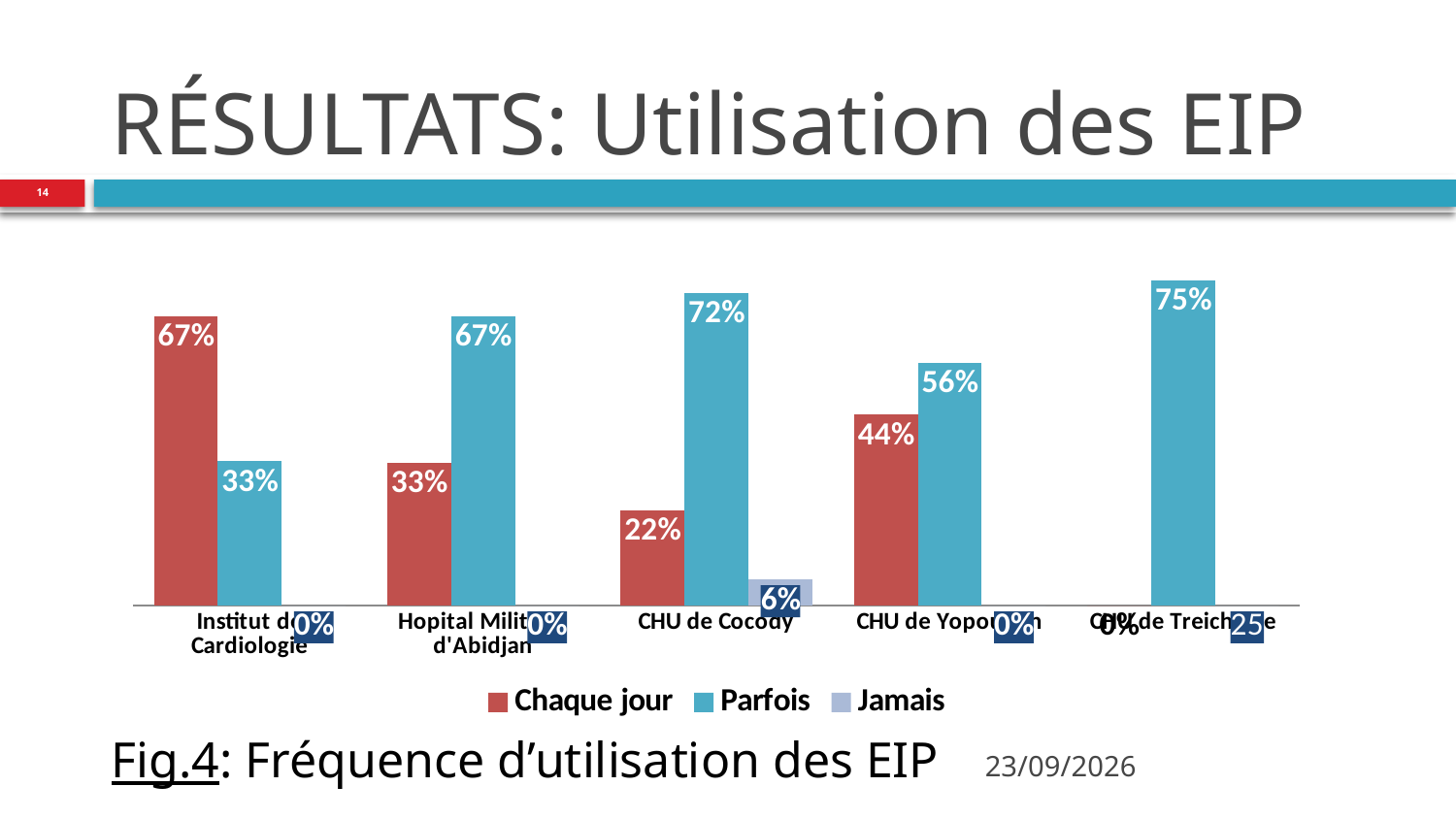
What is the highest Parfois value shown on the chart? 75% How many series does the legend list? 3 What is the Chaque jour value for CHU de Yopougon? 44% Which category has the highest Chaque jour value? Institut de Cardiologie Which category has the lowest Chaque jour value among the first four categories (Institut de Cardiologie, Hopital Militaire d'Abidjan, CHU de Cocody, CHU de Yopougon)? CHU de Cocody What kind of chart is shown on the slide? Bar chart What is the difference between the Parfois and Chaque jour values for Hopital Militaire d'Abidjan? 34 percentage points For Institut de Cardiologie, which is larger: Chaque jour or Parfois? Chaque jour What is the Parfois value for CHU de Cocody? 72% What is the Jamais value for CHU de Cocody? 6% What is the Parfois value for Hopital Militaire d'Abidjan? 67% What is the Chaque jour value for Institut de Cardiologie? 67%